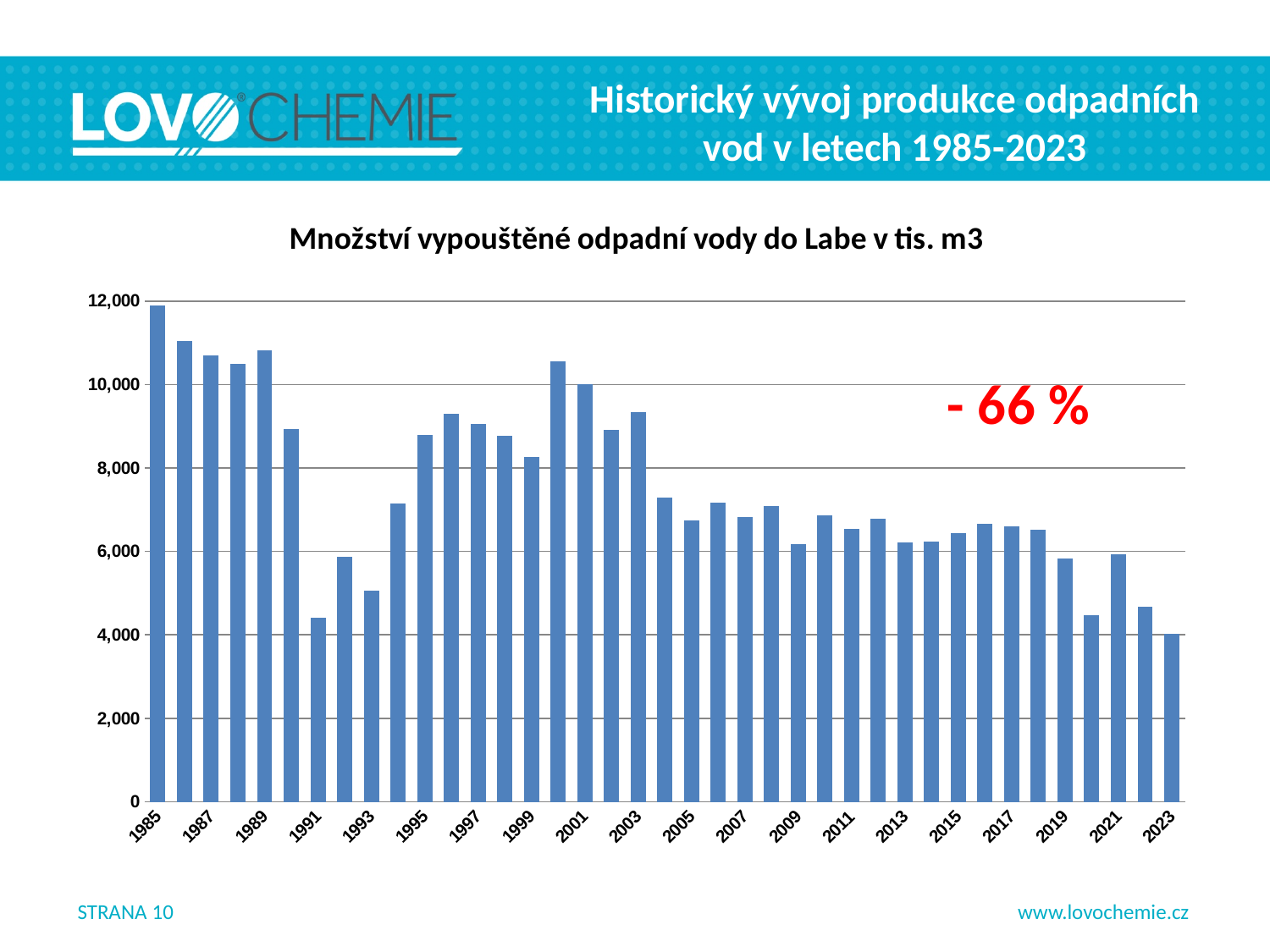
Which year has the lowest bar in the chart? 2023 What percentage change is annotated in red on the chart? - 66 % Overall, do the values rise or fall from 1985 to 2023? fall Which year has the larger value, 2003 or 2023? 2003 Which year has the highest bar in the chart? 1985 Is the value for 2003 greater or less than 8,000? greater What kind of chart is shown on the slide? bar chart Which year has the larger value, 1989 or 1991? 1989 Is the value for 2005 greater or less than 8,000? less Is the value for 1991 greater or less than 6,000? less What is the title of the chart? Množství vypouštěné odpadní vody do Labe v tis. m3